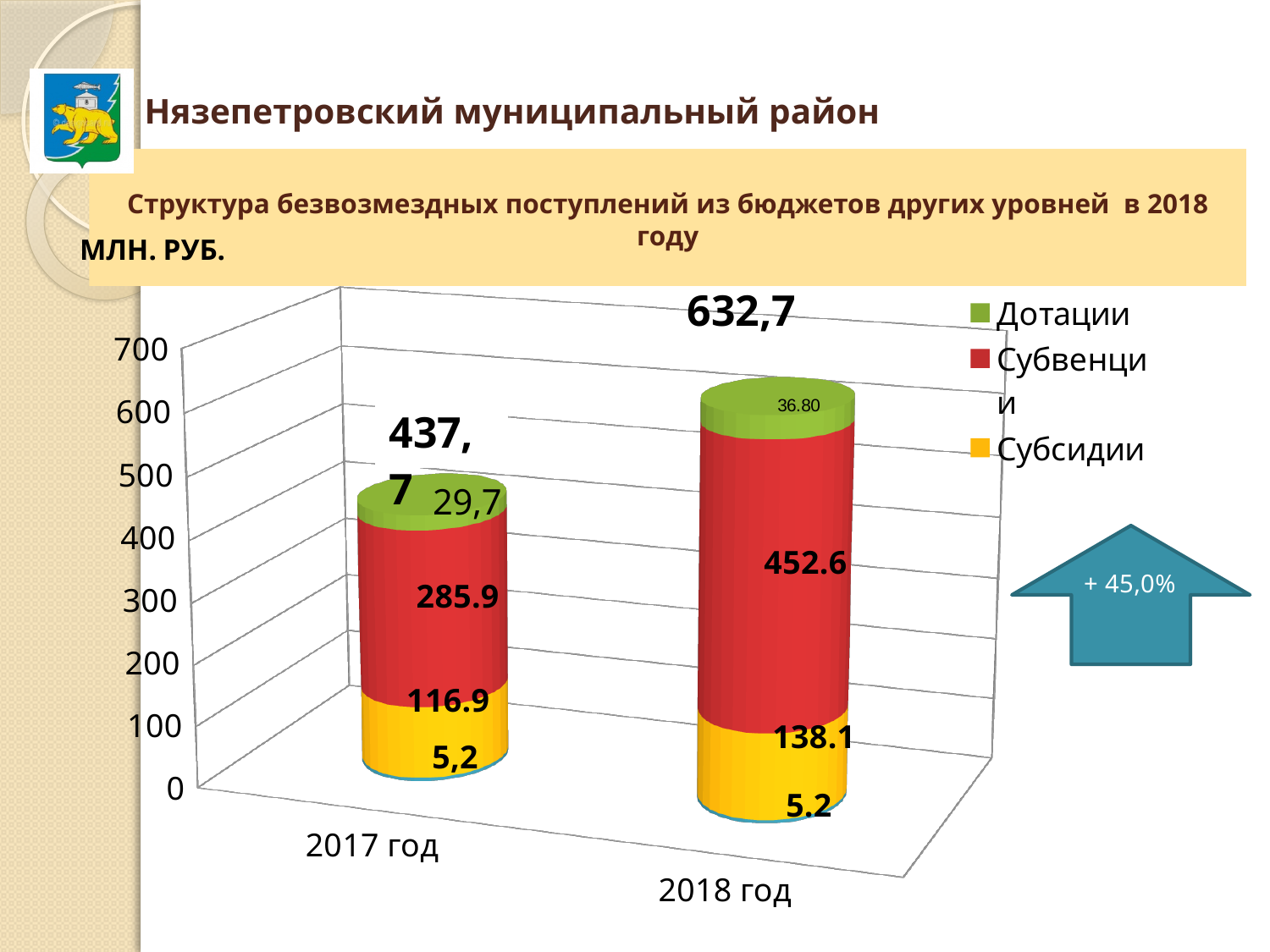
Which year has the larger total of receipts, 2017 год or 2018 год? 2018 год How many series does the chart legend list? 3 What is the value of Субвенции for 2018 год? 452.6 What is the value of Субсидии for 2017 год? 116.9 What is the total labelled above the bar for 2018 год? 632,7 What is the value of Субсидии for 2018 год? 138.1 By how much did Субвенции increase from 2017 год to 2018 год? 166.7 What is the value of Дотации for 2018 год? 36.80 What kind of chart is shown on the slide? bar chart How many categories (years) are shown on the x axis of the chart? 2 What is the total labelled above the bar for 2017 год? 437,7 What is the value of Субвенции for 2017 год? 285.9